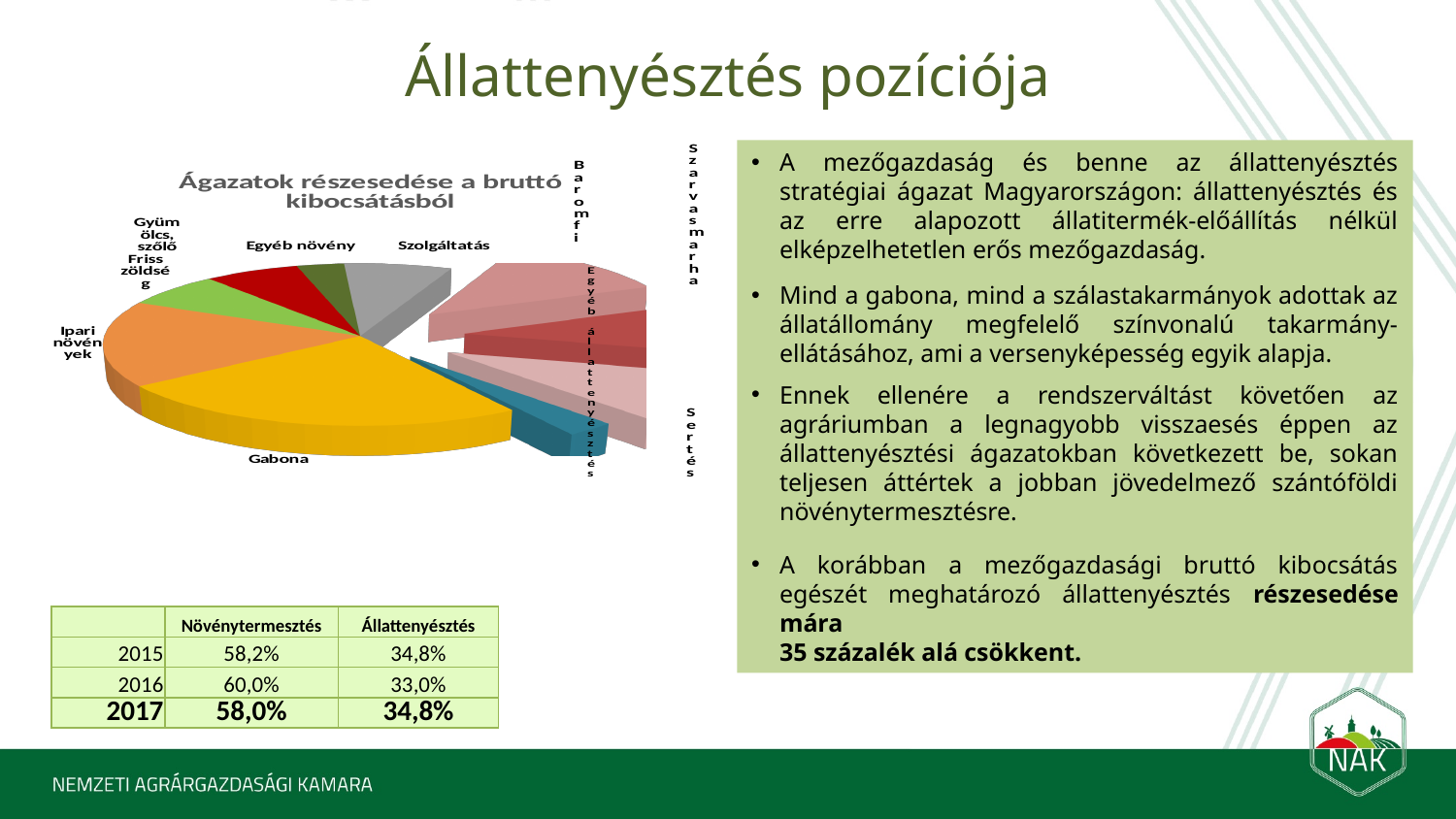
What kind of chart is shown on the slide? pie chart In the pie chart, which slice is larger: Gabona or Sertés? Gabona How many slices does the pie chart have? 10 Which category has the largest slice in the pie chart? Gabona In the pie chart, which slice is larger: Gabona or Szolgáltatás? Gabona What is the title of the pie chart? Ágazatok részesedése a bruttó kibocsátásból What colour is the Gabona slice in the pie chart? yellow In the pie chart, which slice is larger: Ipari növények or Friss zöldség? Ipari növények